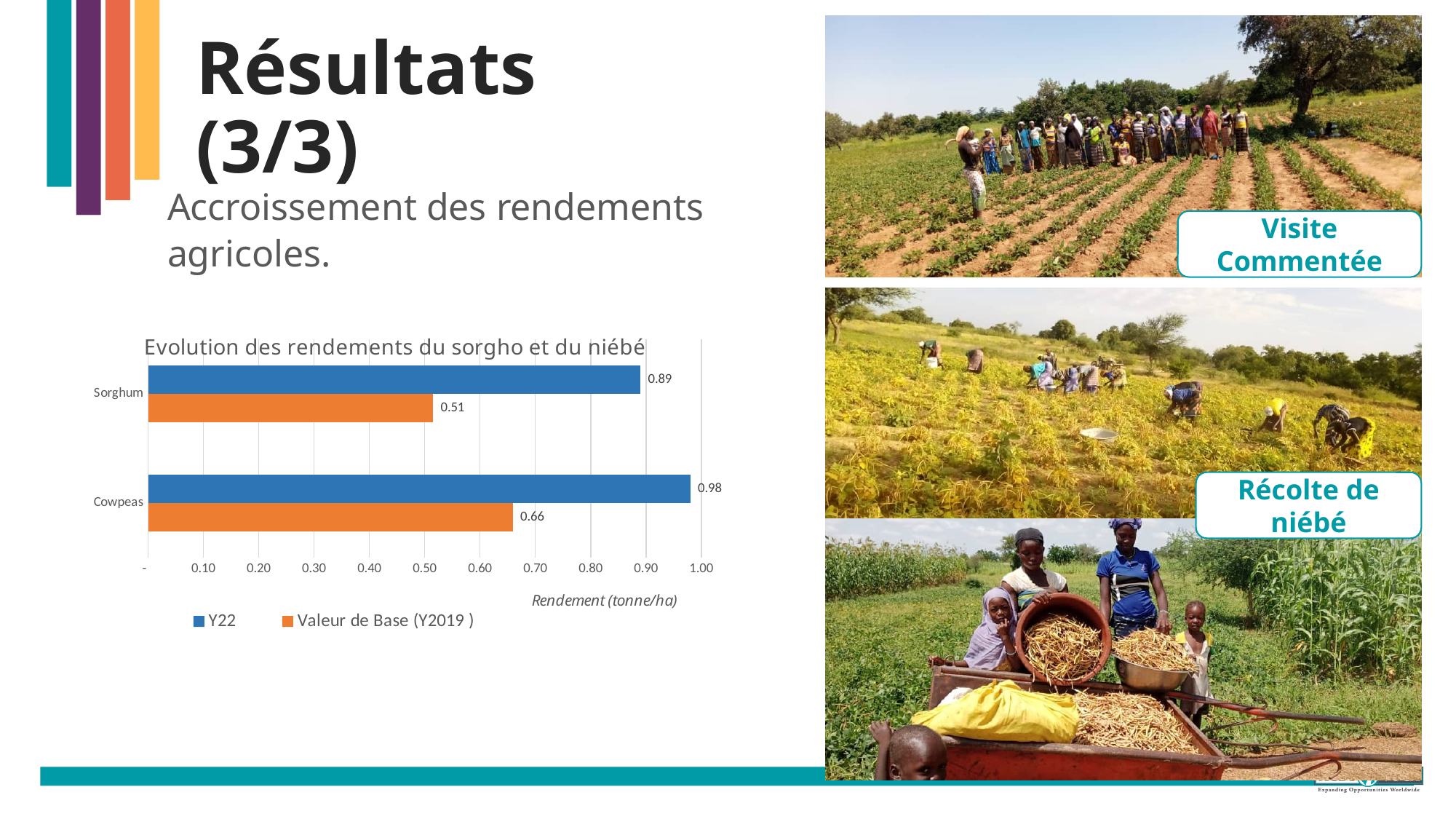
How many series does the legend list? 2 What is the Y22 value for Sorghum? 0.89 Which category has the highest Y22 value? Cowpeas Which category has the lowest Valeur de Base (Y2019) value? Sorghum What kind of chart is shown on the slide? Bar chart What is the difference between the Y22 and Valeur de Base (Y2019) values for Cowpeas? 0.32 Which is larger: the Y22 value for Sorghum or the Y22 value for Cowpeas? Cowpeas What is the Valeur de Base (Y2019) value for Cowpeas? 0.66 What is the Valeur de Base (Y2019) value for Sorghum? 0.51 What is the difference between the Y22 and Valeur de Base (Y2019) values for Sorghum? 0.38 What is the Y22 value for Cowpeas? 0.98 What is the title of the chart? Evolution des rendements du sorgho et du niébé